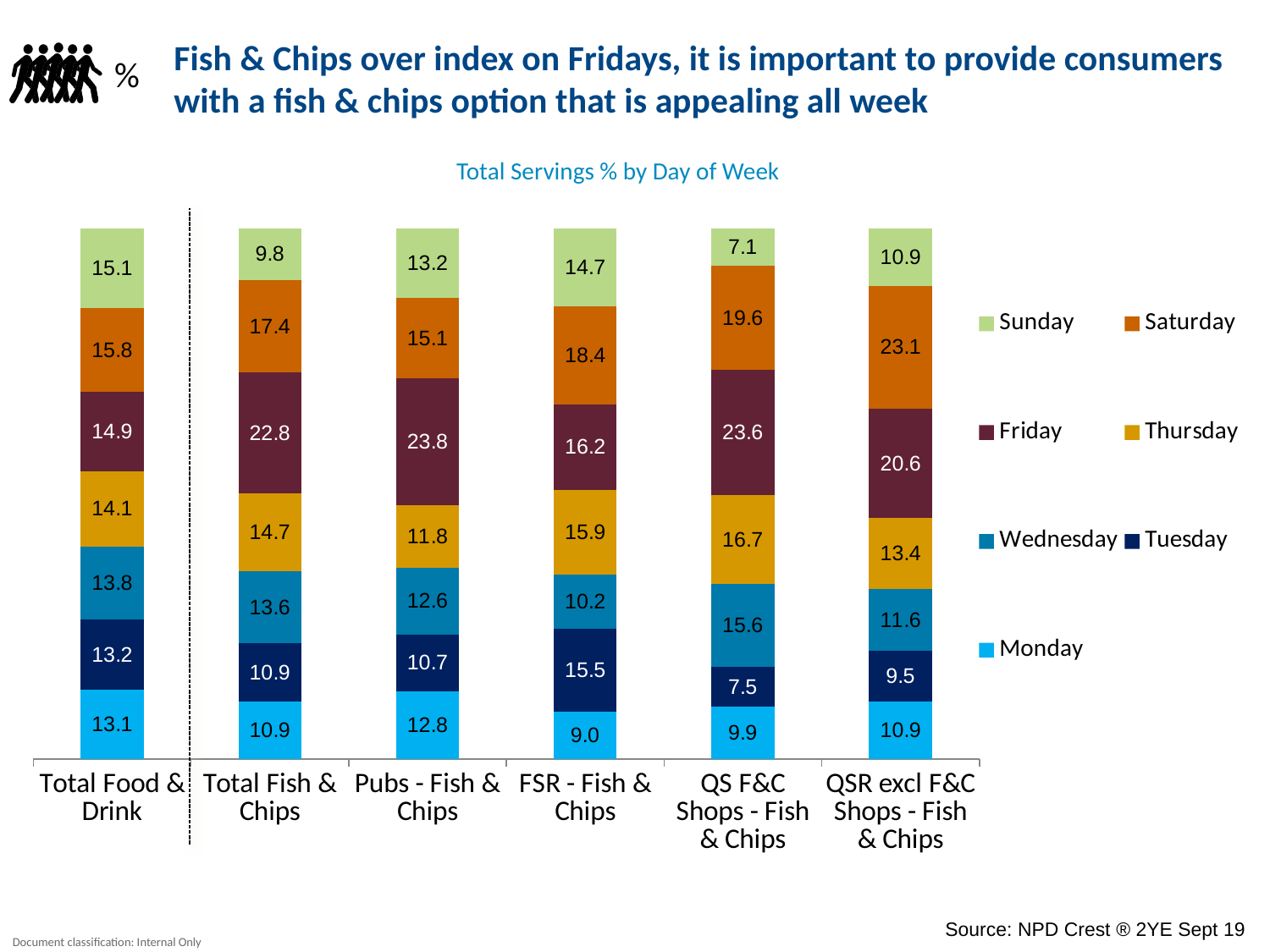
What is the Friday value for Pubs - Fish & Chips? 23.8 What is the Saturday value for QSR excl F&C Shops - Fish & Chips? 23.1 What is the title of the chart? Total Servings % by Day of Week How much higher is the Friday value for Total Fish & Chips than for Total Food & Drink? 7.9 How many series does the chart's legend list? 7 What kind of chart is shown on the slide? Stacked bar chart Which has the larger Saturday value: QS F&C Shops - Fish & Chips or FSR - Fish & Chips? QS F&C Shops - Fish & Chips What is the Monday value for FSR - Fish & Chips? 9.0 Which category has the lowest Sunday value? QS F&C Shops - Fish & Chips Which category has the highest Friday value? Pubs - Fish & Chips How many categories (channels) are shown along the x axis of the chart? 6 What is the difference between the Tuesday value for Total Food & Drink and the Tuesday value for QS F&C Shops - Fish & Chips? 5.7